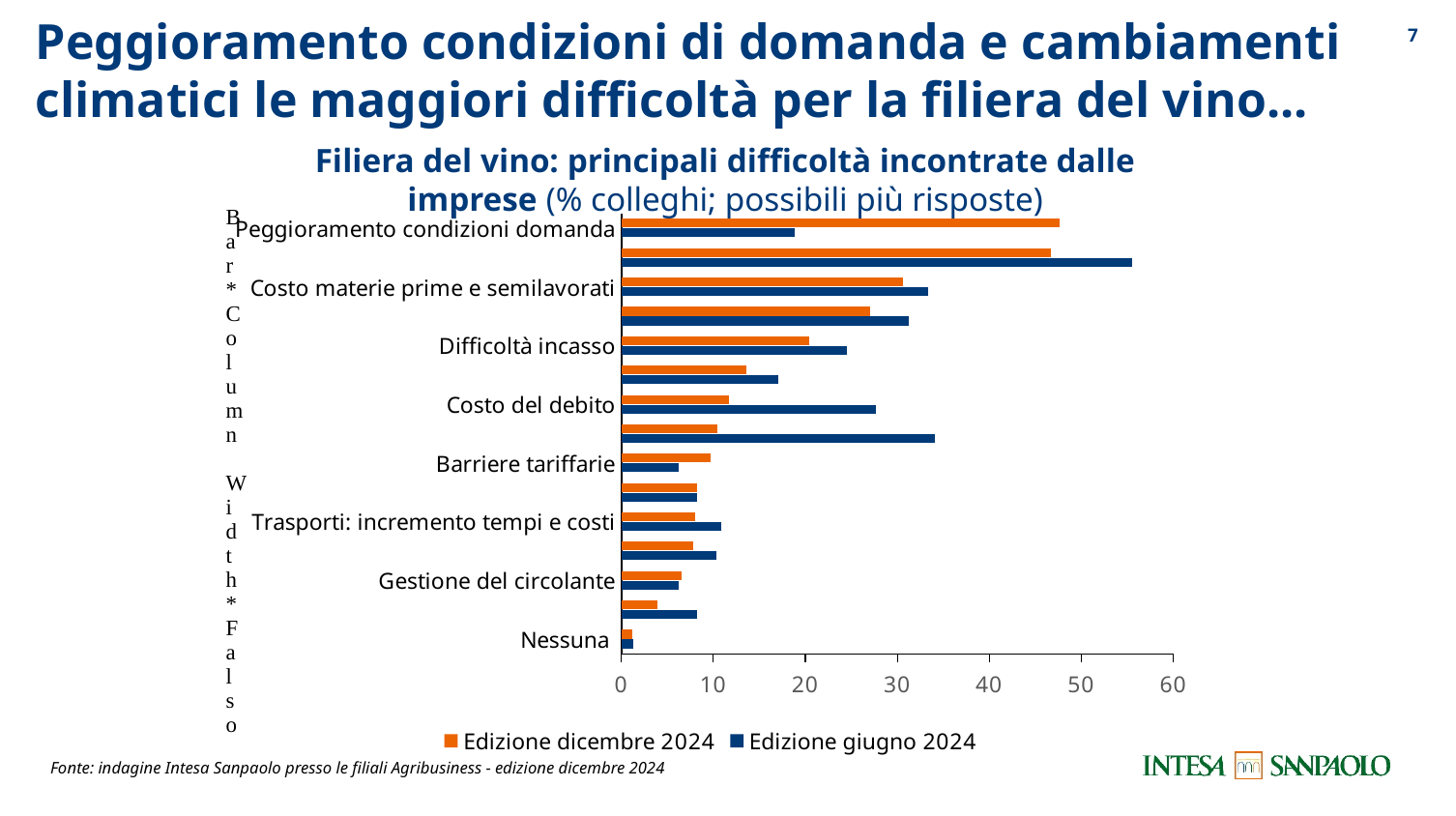
For Peggioramento condizioni domanda, is the value for Edizione dicembre 2024 greater or less than 40? greater For Costo del debito, which series has the larger value, Edizione dicembre 2024 or Edizione giugno 2024? Edizione giugno 2024 For Peggioramento condizioni domanda, is the value for Edizione giugno 2024 greater or less than 30? less For Barriere tariffarie, is the value for Edizione dicembre 2024 greater or less than 20? less What kind of chart is shown on the slide? bar chart How many series does the legend list? 2 What are the two series named in the legend? Edizione dicembre 2024 and Edizione giugno 2024 Which colour represents Edizione giugno 2024 in the chart? blue For Peggioramento condizioni domanda, which series has the larger value, Edizione dicembre 2024 or Edizione giugno 2024? Edizione dicembre 2024